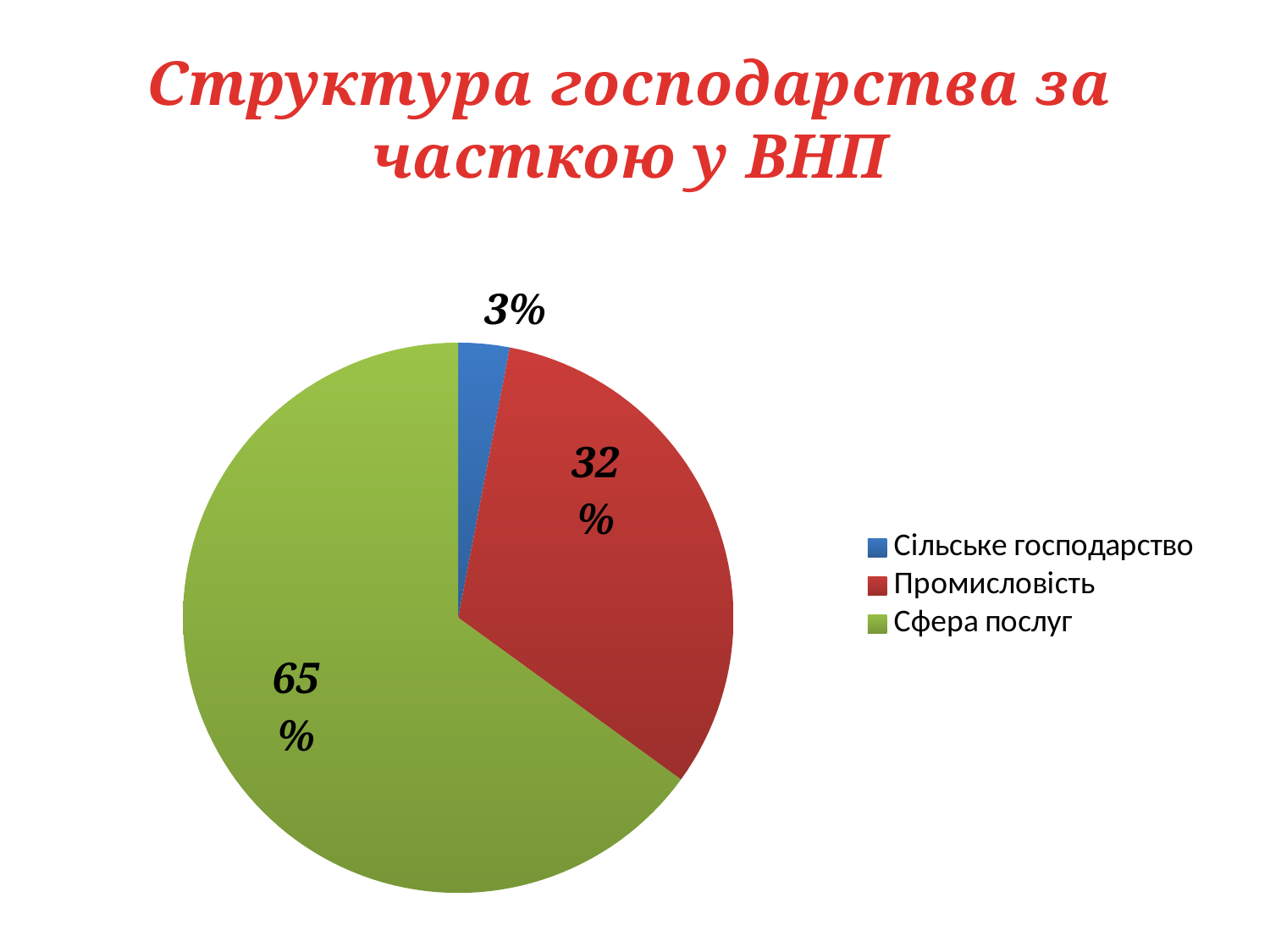
Which is larger, the share of Промисловість or the share of Сільське господарство? Промисловість Which category has the largest slice of the pie? Сфера послуг What is the difference between the shares of Промисловість and Сільське господарство? 29% How many categories are shown in the pie chart? 3 Which colour represents Промисловість in the legend? Red What is the title of the slide? Структура господарства за часткою у ВНП Which category has the smallest slice of the pie? Сільське господарство What kind of chart is shown on the slide? Pie chart What is the difference between the shares of Сфера послуг and Промисловість? 33% What share of the pie does Сфера послуг have? 65% What is the value shown for Промисловість? 32% What is the value shown for Сільське господарство? 3%